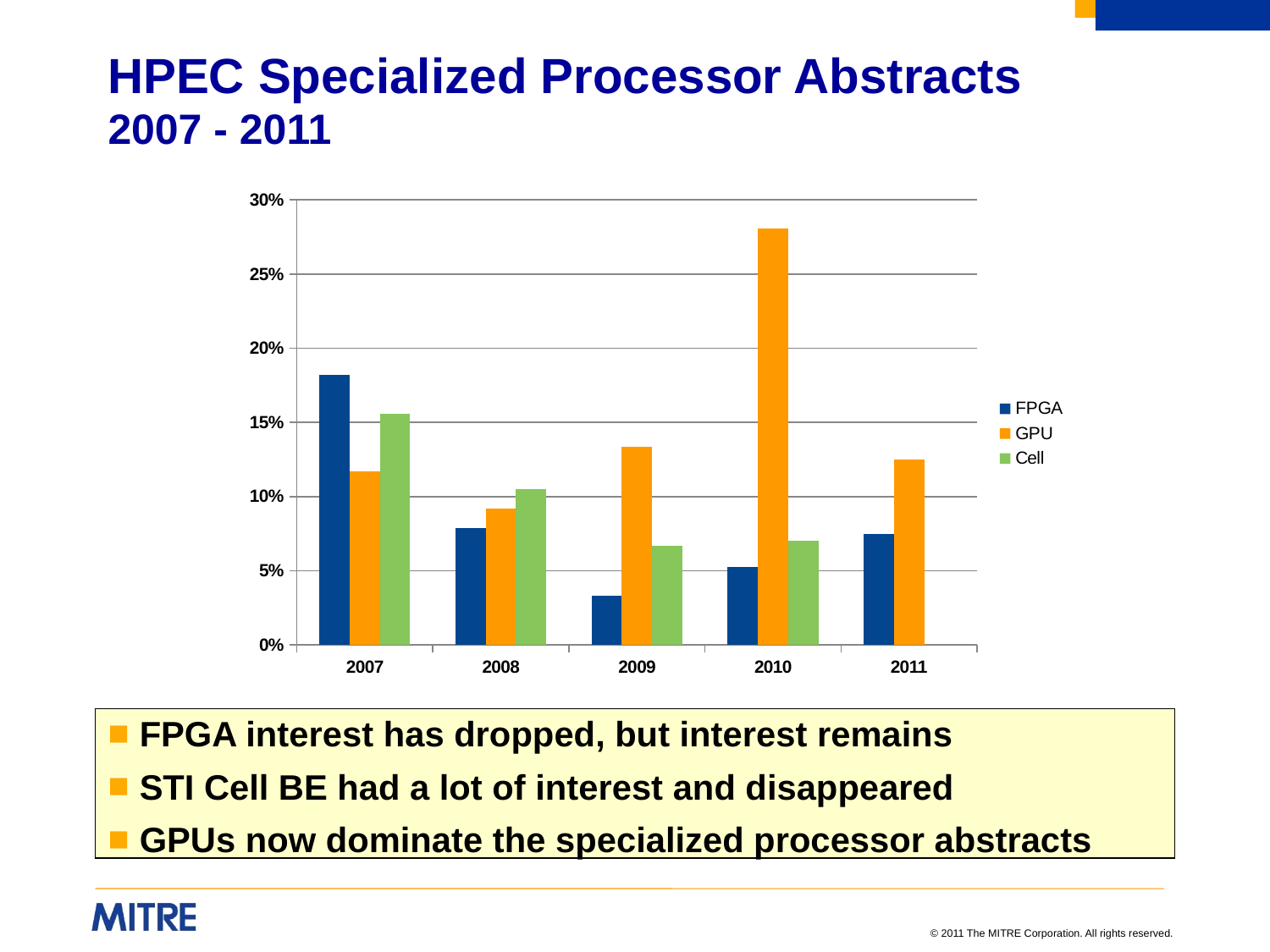
Is the FPGA value for 2007 greater or less than 15%? greater What kind of chart is shown on the slide? bar chart In 2007, which is larger, the FPGA bar or the GPU bar? FPGA How many years are shown on the x axis? 5 In which year is the FPGA bar the lowest? 2009 Is the GPU value for 2010 greater or less than 25%? greater Does the FPGA value rise or fall from 2007 to 2009? fall In which year is the GPU bar the highest? 2010 How many series does the legend list? 3 Is the Cell value for 2009 greater or less than 10%? less In 2009, which is larger, the GPU bar or the Cell bar? GPU Which series are listed in the legend? FPGA, GPU, Cell